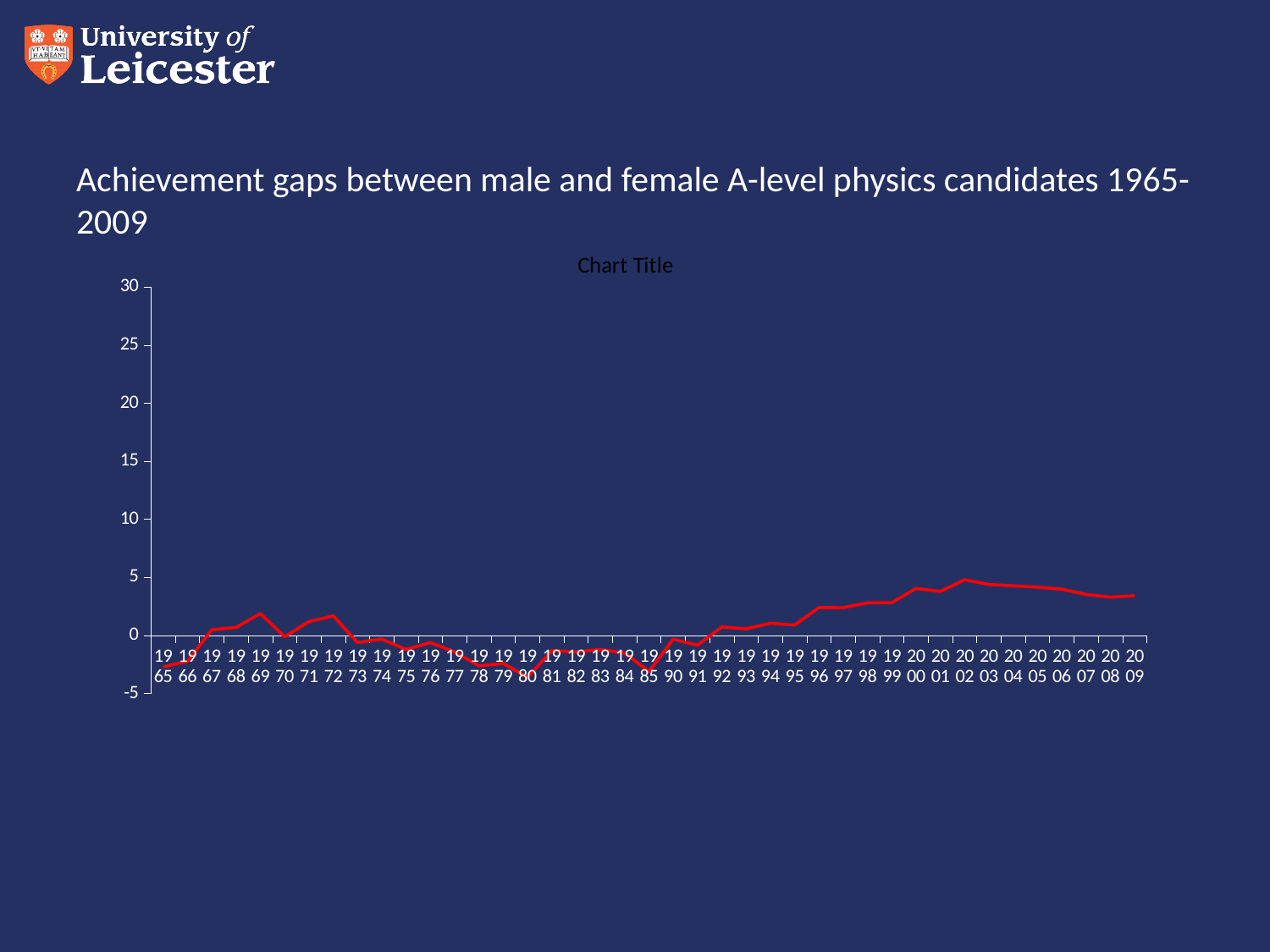
Is the value for 1965 greater or less than 0? less Which year has the highest value on the line? 2002 Is the value for 1980 greater or less than 0? less Which is larger, the value for 2002 or the value for 1965? 2002 Do the values generally rise or fall between 1990 and 2002? rise What is the title printed above the chart's plot area? Chart Title What colour is the plotted line? red How many data points (years) are plotted along the x axis? 41 What kind of chart is shown on the slide? line chart Is the value for 2002 greater or less than 10? less